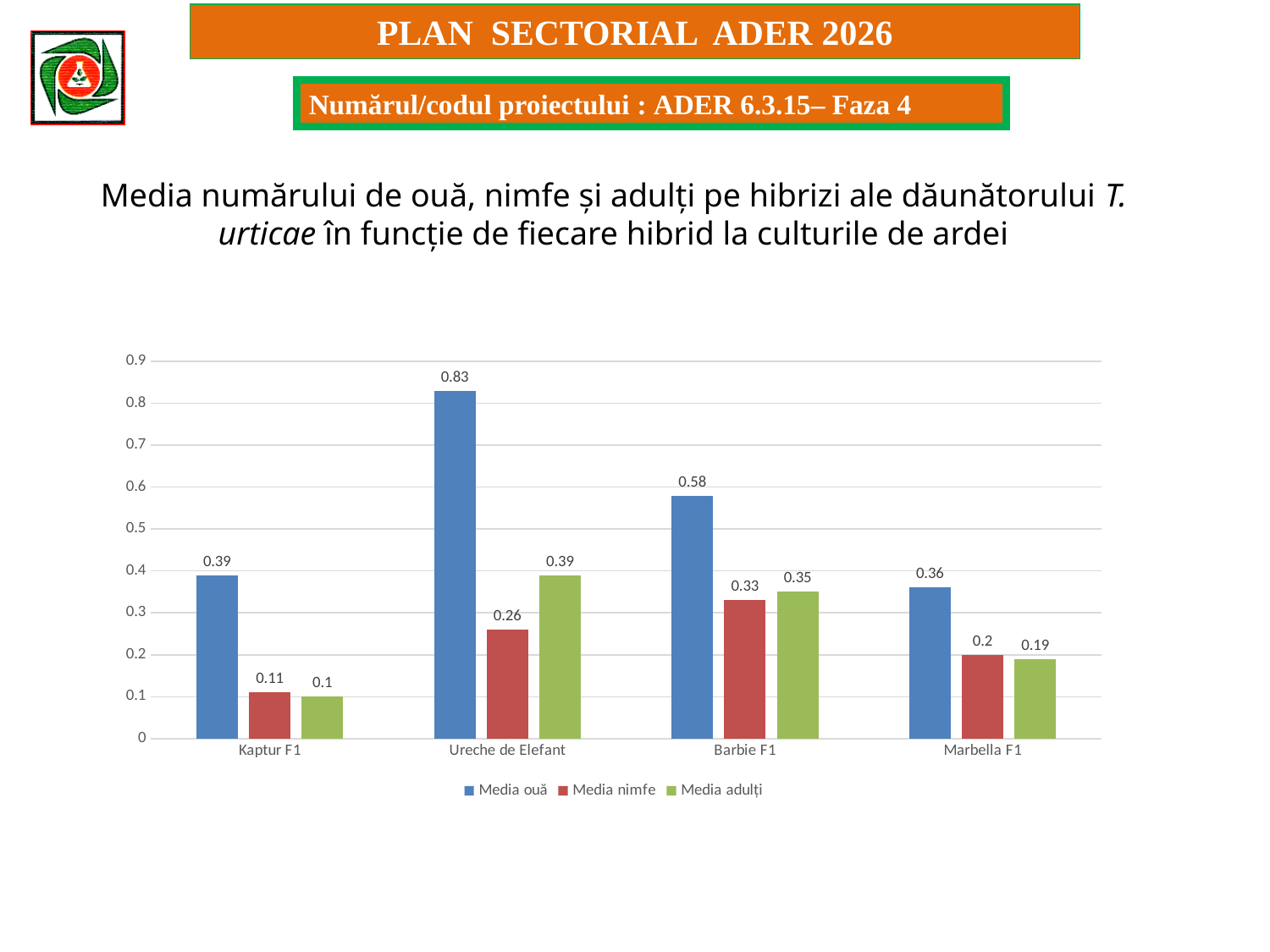
What is the value of Media adulți for Marbella F1? 0.19 What kind of chart is shown on the slide? Bar chart Which series is shown in blue in the legend? Media ouă What is the value of Media nimfe for Kaptur F1? 0.11 Which hybrid has the highest value for Media ouă? Ureche de Elefant Which hybrid has the lowest value for Media adulți? Kaptur F1 Which is larger: Media nimfe for Barbie F1 or Media nimfe for Ureche de Elefant? Media nimfe for Barbie F1 How many series does the legend list? 3 What is the difference between Media ouă for Ureche de Elefant and Media ouă for Barbie F1? 0.25 How many hybrids are shown on the x axis? 4 Is the value of Media ouă for Barbie F1 greater or less than 0.5? greater What is the value of Media ouă for Ureche de Elefant? 0.83